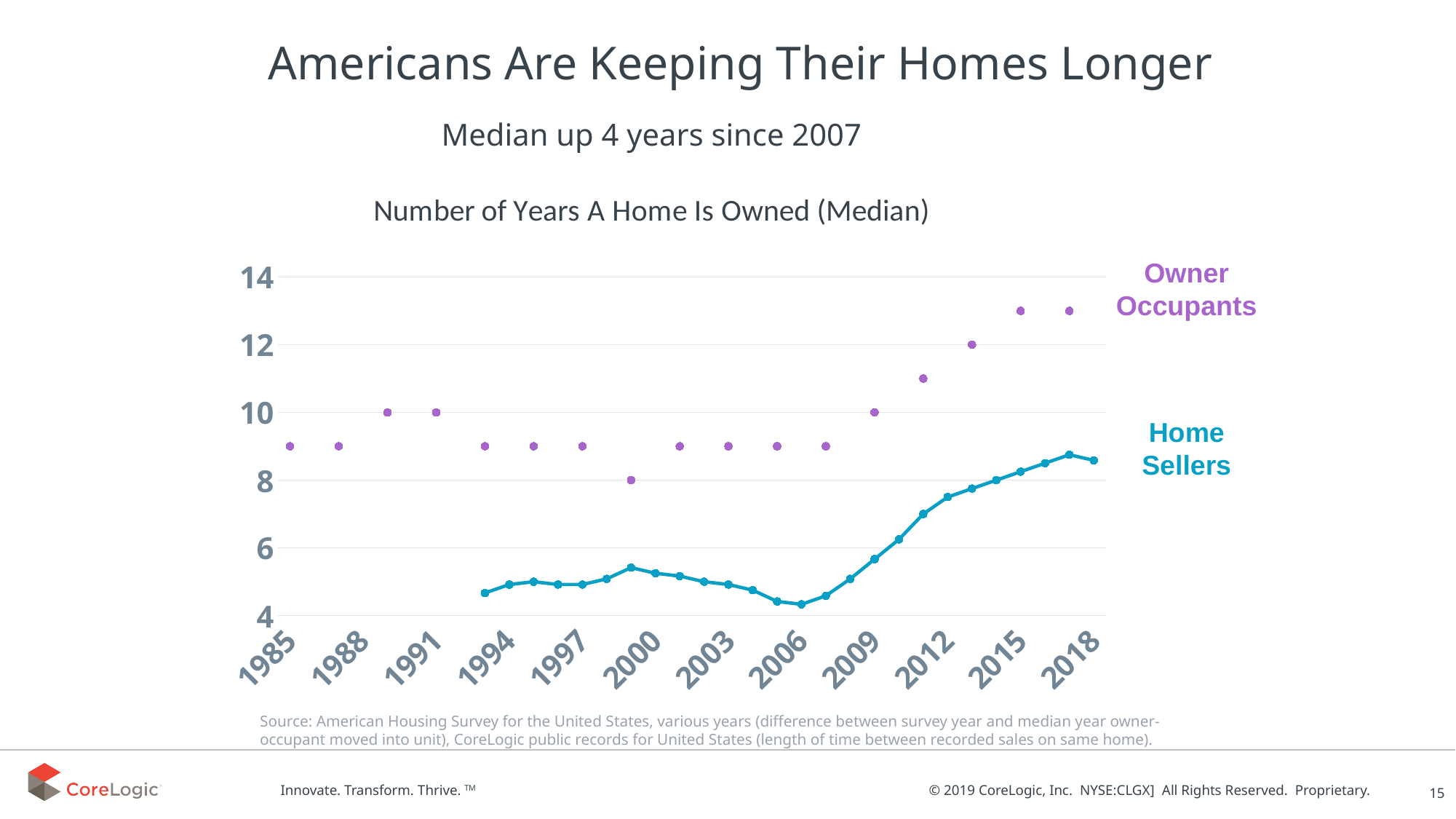
How many year labels are shown on the x axis? 12 Is the Owner Occupants value for 2015 greater or less than 12? greater How many series does the chart show? 2 What is the title of the chart? Number of Years A Home Is Owned (Median) Does the Home Sellers series rise or fall between 2006 and 2018? Rise Is the Home Sellers value for 2018 greater or less than 8? greater What type of chart is shown on the slide? Line chart What is the Owner Occupants value in 1991? 10 Is the Owner Occupants value for 2003 greater or less than 10? less What is the Owner Occupants value in 2009? 10 In 2009, which series has the higher value, Owner Occupants or Home Sellers? Owner Occupants